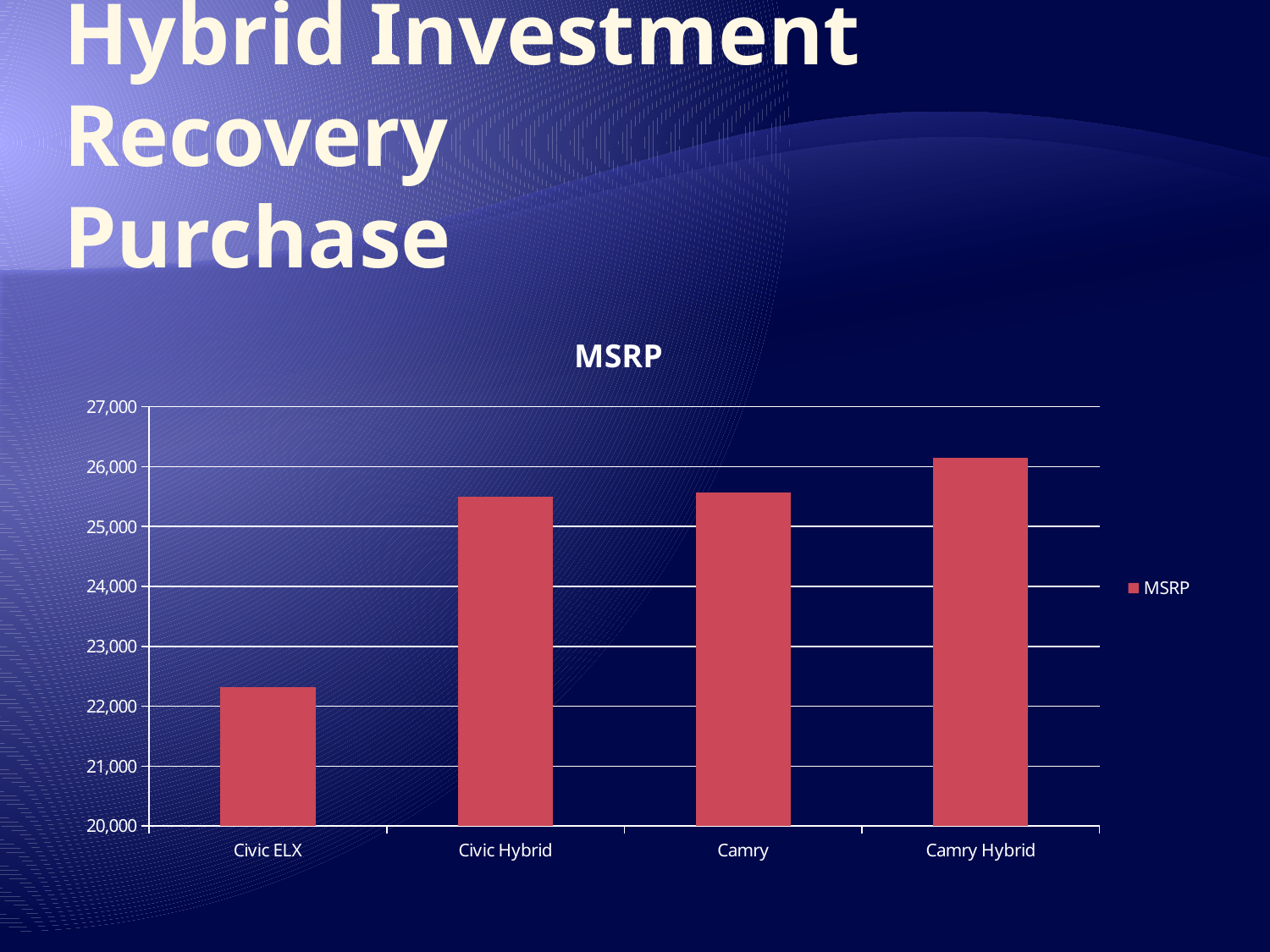
How many categories are shown on the x axis of the chart? 4 What is the title of the chart? MSRP Which has a higher MSRP, Civic ELX or Civic Hybrid? Civic Hybrid Which category has the lowest MSRP? Civic ELX Is the MSRP for Civic ELX greater or less than 23,000? less How many series does the chart's legend list? 1 Is the MSRP for Civic Hybrid greater or less than 25,000? greater Which category has the highest MSRP? Camry Hybrid Is the MSRP for Camry Hybrid greater or less than 27,000? less Which has a higher MSRP, Camry or Camry Hybrid? Camry Hybrid What kind of chart is shown on the slide? bar chart